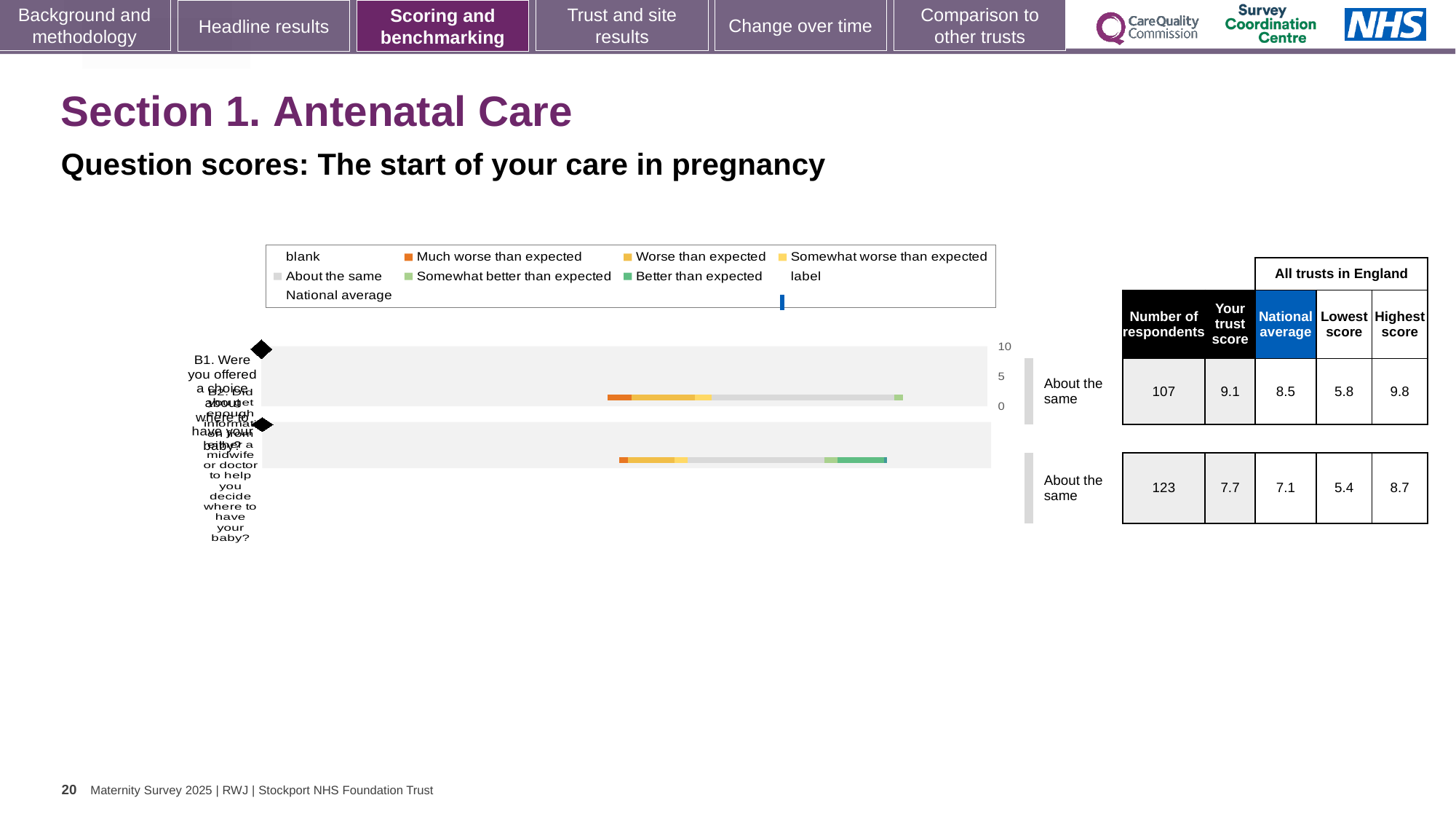
In the table beside the chart, what is the national average for question B2? 7.1 For question B2, which is larger: the trust score or the national average? the trust score Which question has the higher 'Your trust score', B1 or B2? B1 In the table beside the chart, how many respondents are listed for question B2? 123 What is the highest tick value shown on the chart's score axis? 10 What is the difference between the trust scores for B1 (9.1) and B2 (7.7)? 1.4 What colour does the legend use for 'Much worse than expected'? orange In the table beside the chart, what is the highest score for question B1? 9.8 What kind of chart is shown on the slide? bar chart What benchmark category is shown next to the bar for question B1? About the same In the table beside the chart, what is 'Your trust score' for question B1? 9.1 How many questions (categories) are plotted in the chart? 2